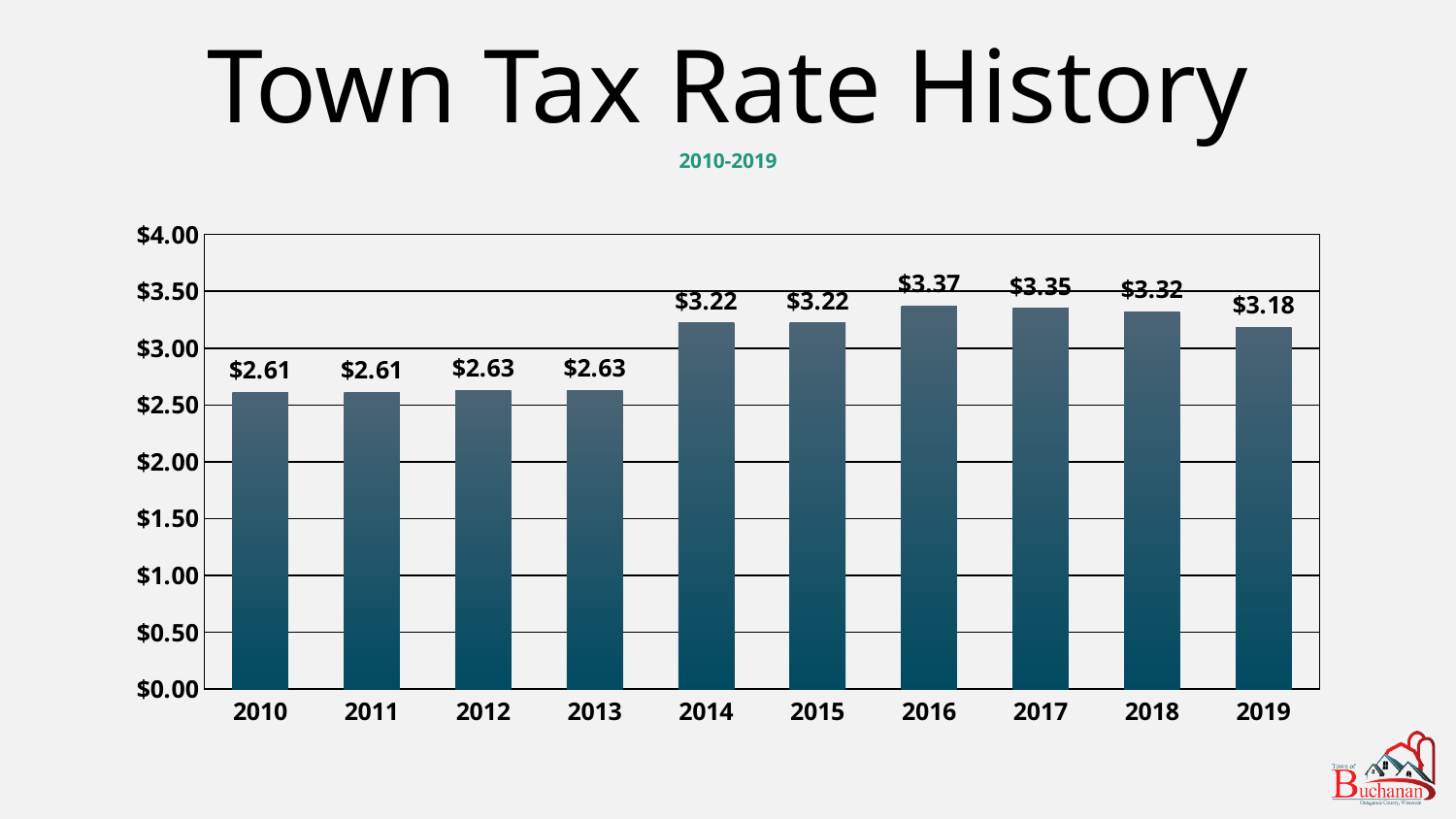
What is the title of the chart? Town Tax Rate History Is the tax rate for 2012 greater or less than $3.00? less How many years are shown on the chart? 10 What is the town tax rate for 2010? $2.61 Which year has the highest town tax rate? 2016 What kind of chart is shown on the slide? bar chart Which is larger, the tax rate in 2017 or the tax rate in 2018? 2017 What is the difference between the tax rate in 2014 and the tax rate in 2013? $0.59 What is the town tax rate for 2019? $3.18 Does the tax rate rise or fall from 2016 to 2019? fall What is the difference between the tax rate in 2016 and the tax rate in 2019? $0.19 What is the town tax rate for 2016? $3.37